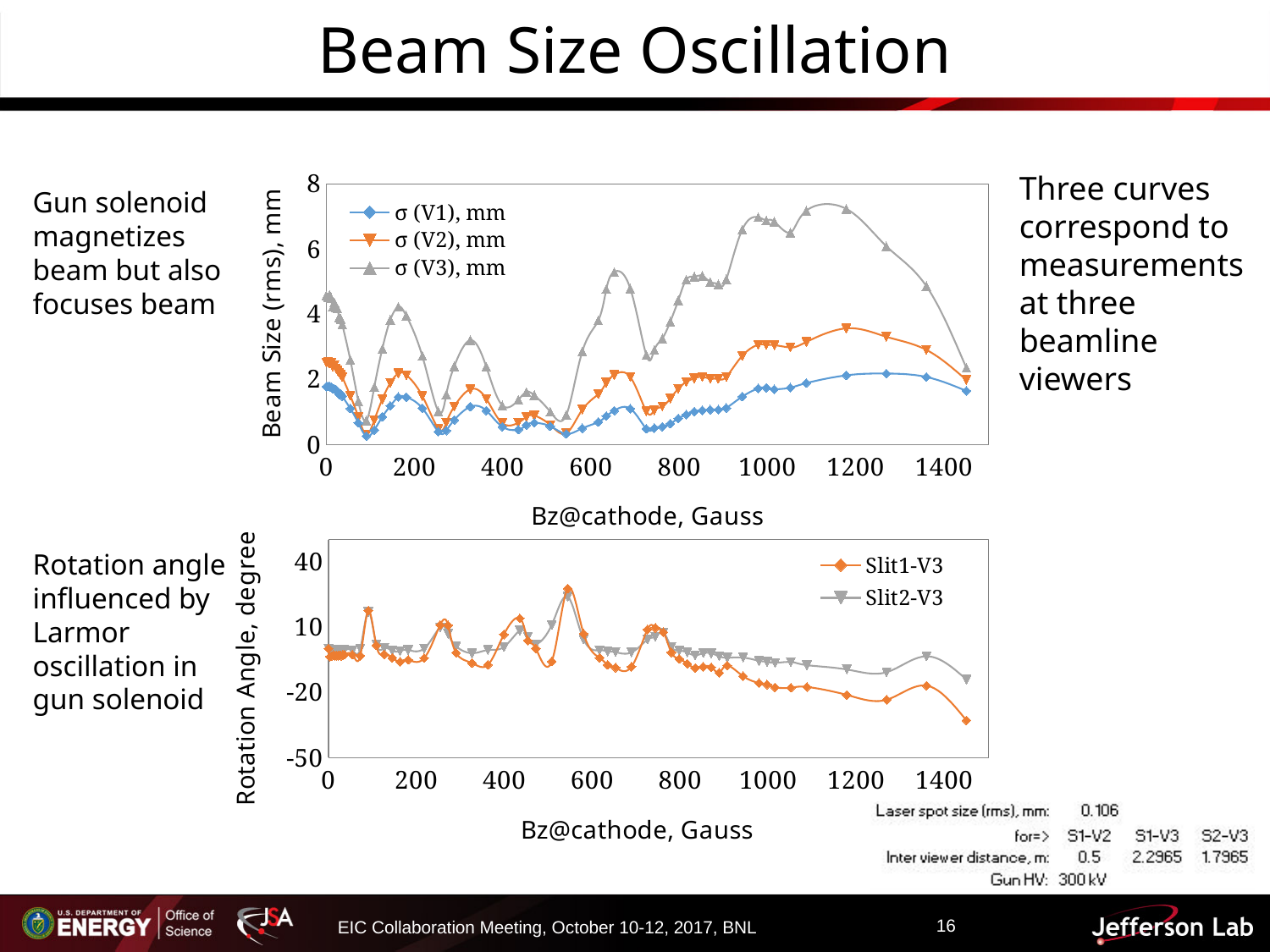
In the bottom chart, at 1200 Gauss, which series has the larger value, Slit1-V3 or Slit2-V3? Slit2-V3 How many series does the legend of the top chart list? 3 What is the y-axis title of the bottom chart? Rotation Angle, degree How many series does the legend of the bottom chart list? 2 In the top chart, is the value of σ (V1) at 1200 Gauss greater or less than 4? less What is the x-axis title of the top chart? Bz@cathode, Gauss What type of chart is the top chart on the slide? Line chart In the bottom chart, is the value of Slit2-V3 at 1400 Gauss greater or less than -20? greater In the top chart, is the value of σ (V3) at 1200 Gauss greater or less than 6? greater In the top chart, which series has the lowest values overall? σ (V1), mm In the top chart, which series has the highest values overall? σ (V3), mm